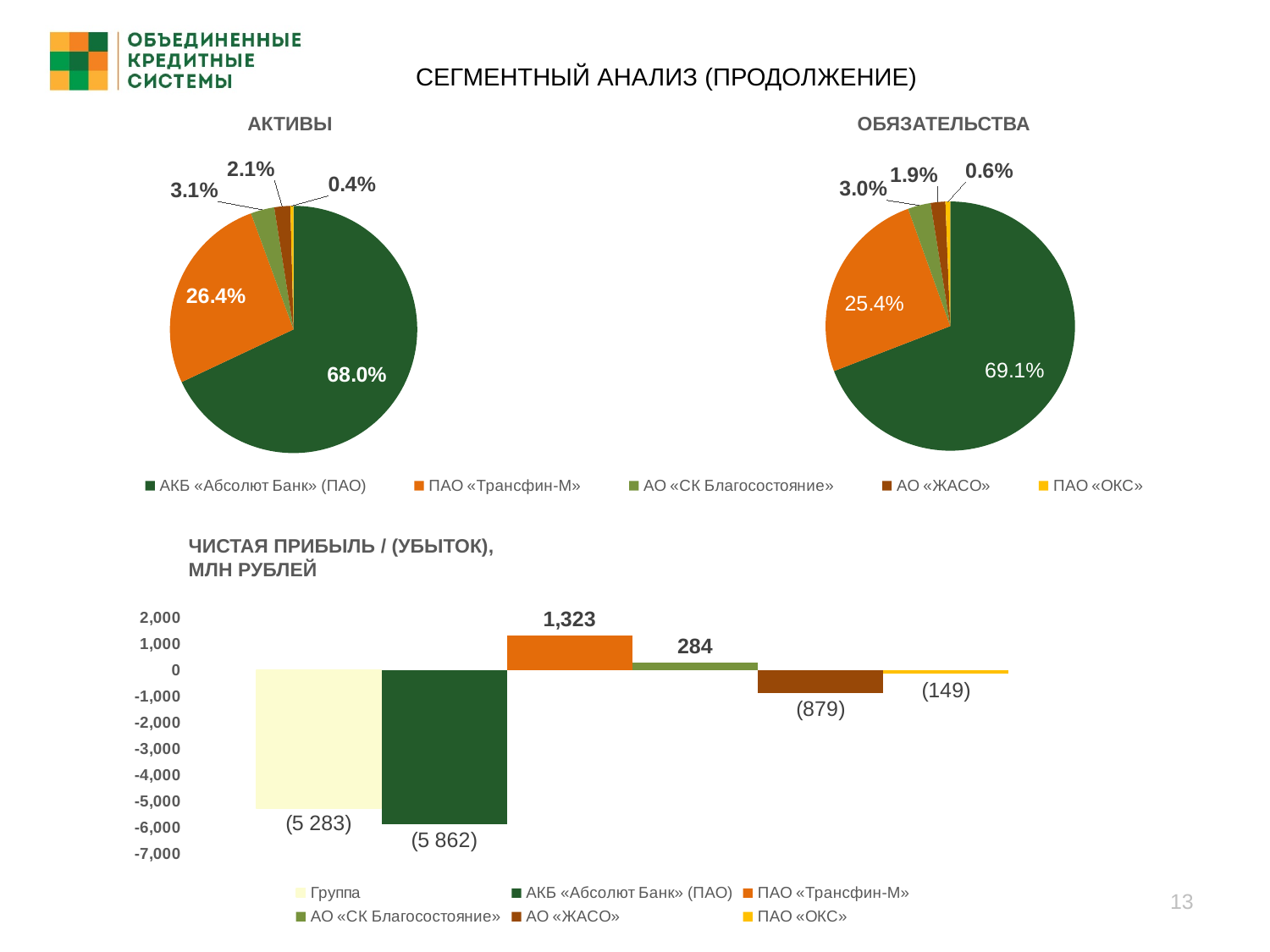
In the ЧИСТАЯ ПРИБЫЛЬ / (УБЫТОК) chart, which company has the highest value? ПАО «Трансфин-М» In the ЧИСТАЯ ПРИБЫЛЬ / (УБЫТОК) chart, what is the value for АО «ЖАСО»? (879) In the ЧИСТАЯ ПРИБЫЛЬ / (УБЫТОК) chart, what is the value for ПАО «Трансфин-М»? 1,323 In the АКТИВЫ pie chart, what share does ПАО «Трансфин-М» hold? 26.4% In the ОБЯЗАТЕЛЬСТВА pie chart, which company has the smallest share? ПАО «ОКС» In the АКТИВЫ pie chart, how many slices are there? 5 In the ОБЯЗАТЕЛЬСТВА pie chart, what share does АКБ «Абсолют Банк» (ПАО) hold? 69.1% In the АКТИВЫ pie chart, what share does АКБ «Абсолют Банк» (ПАО) hold? 68.0% In the ЧИСТАЯ ПРИБЫЛЬ / (УБЫТОК) chart, which is larger: the value for ПАО «Трансфин-М» or the value for АО «СК Благосостояние»? ПАО «Трансфин-М» In the ЧИСТАЯ ПРИБЫЛЬ / (УБЫТОК) chart, what is the value for АКБ «Абсолют Банк» (ПАО)? (5 862) What kind of chart is the ЧИСТАЯ ПРИБЫЛЬ / (УБЫТОК) chart? Bar chart